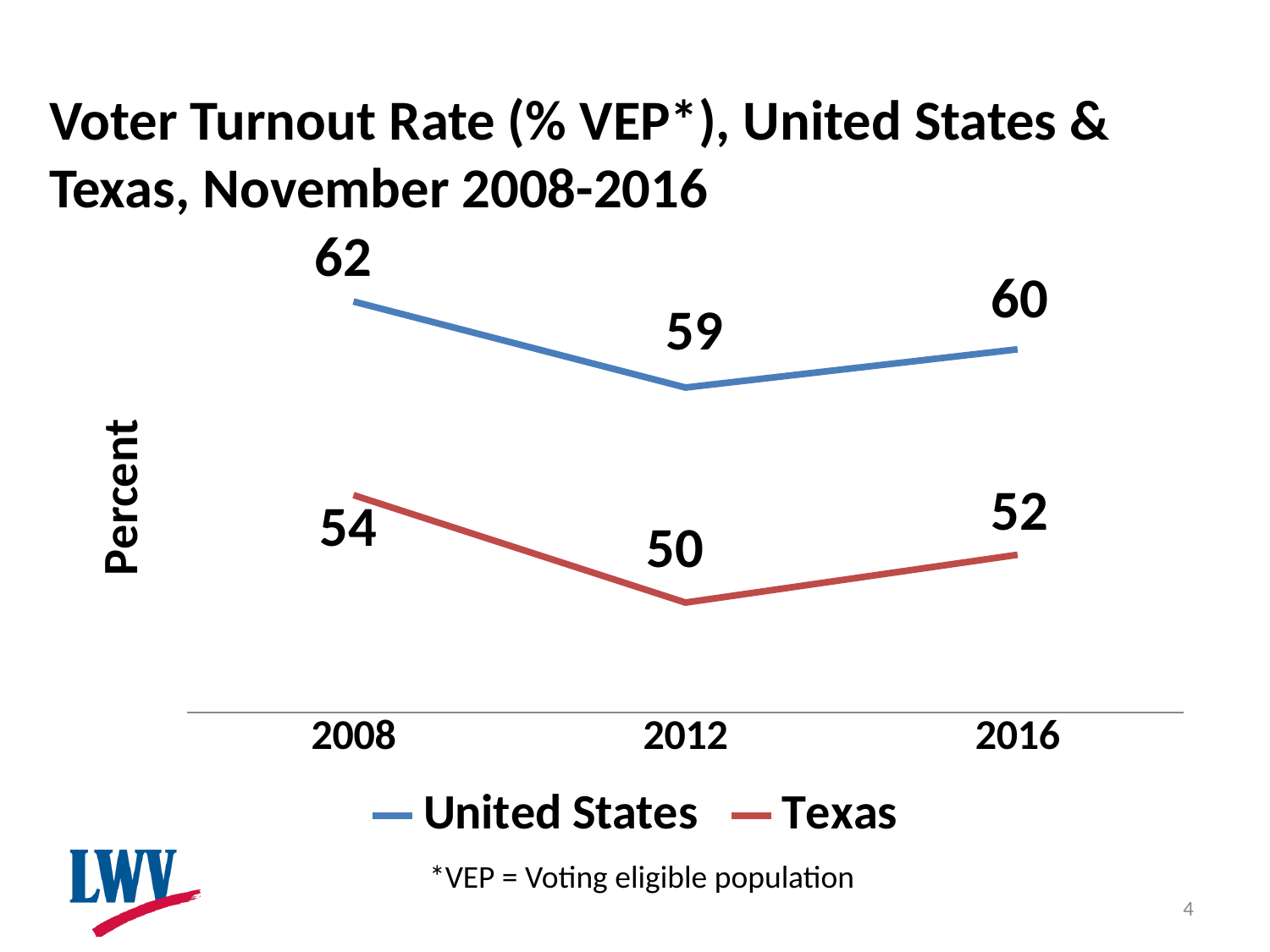
In which year was the United States voter turnout rate lowest? 2012 By how much did the Texas voter turnout rate fall from 2008 to 2012? 4 What was the voter turnout rate for Texas in 2016? 52 What was the voter turnout rate for the United States in 2008? 62 What was the voter turnout rate for Texas in 2012? 50 How many series does the legend list? 2 Did the United States voter turnout rate rise or fall from 2012 to 2016? Rise Which had a higher voter turnout rate in 2016, the United States or Texas? United States What kind of chart is shown on the slide? Line chart How many years are shown on the x axis? 3 What is the difference between the United States and Texas voter turnout rates in 2012? 9 In which year was the Texas voter turnout rate highest? 2008